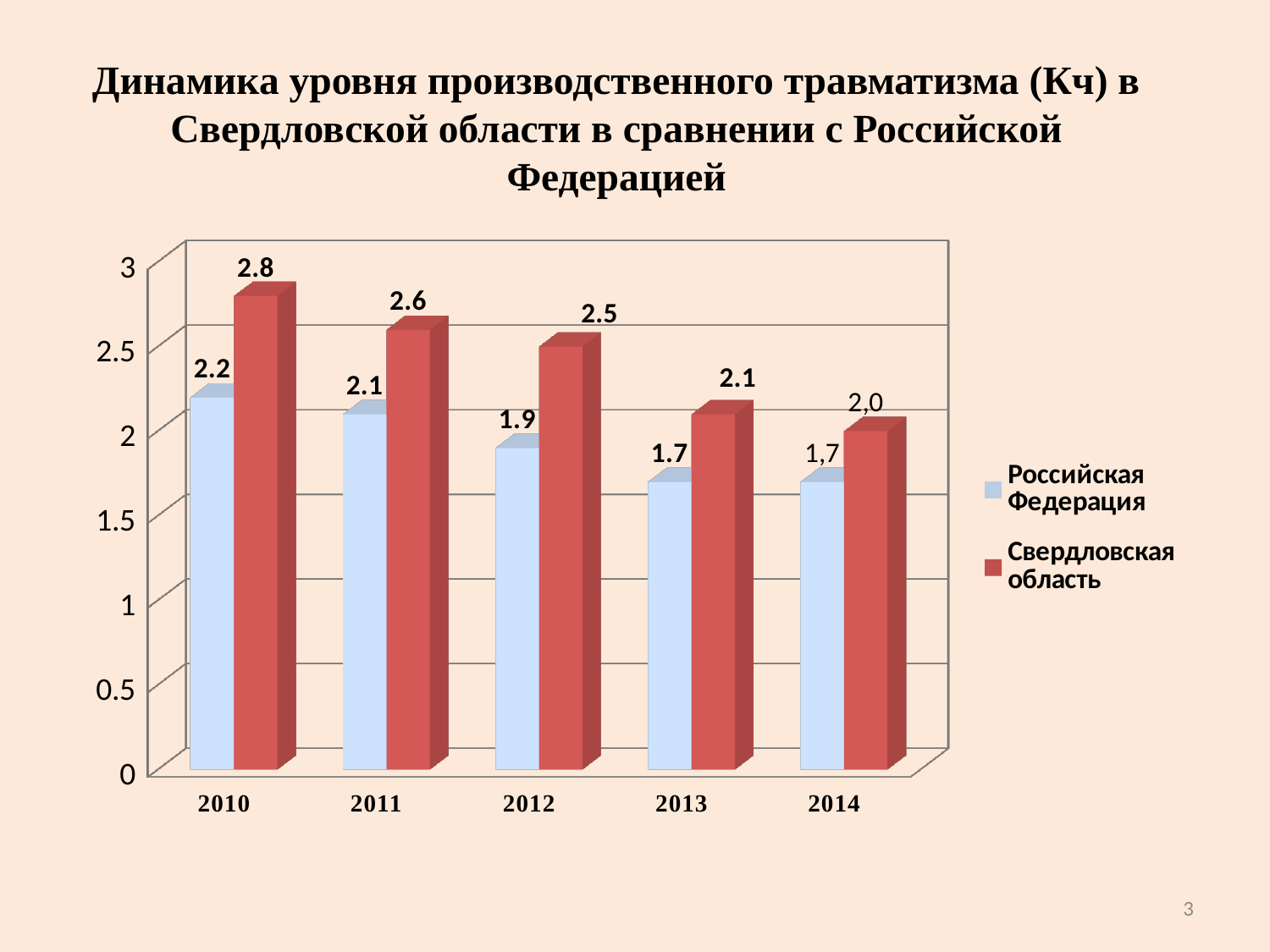
Do the values for Свердловская область rise or fall from 2010 to 2014? fall In which year is the value for Свердловская область highest? 2010 Which is larger in 2013: Российская Федерация or Свердловская область? Свердловская область What is the value for Свердловская область in 2014? 2,0 What is the difference between Свердловская область and Российская Федерация in 2011? 0.5 In which year is the value for Российская Федерация lowest? 2013 and 2014 (both 1.7) What is the value for Российская Федерация in 2010? 2.2 How many series does the legend list? 2 What kind of chart is shown on the slide? bar chart What is the value for Российская Федерация in 2013? 1.7 How many years are shown on the x axis? 5 What is the value for Свердловская область in 2012? 2.5